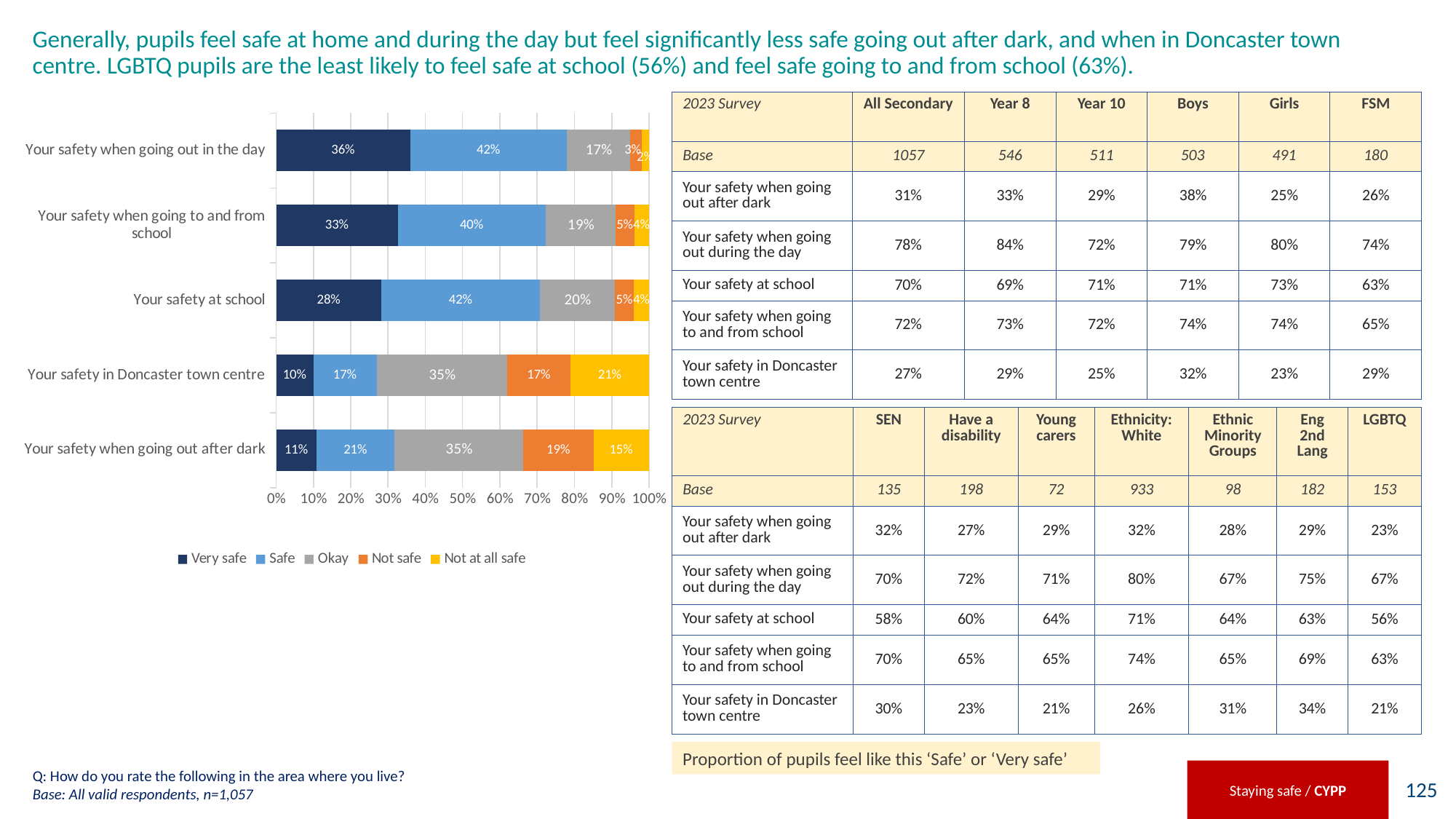
What is the combined 'Very safe' and 'Safe' total for 'Your safety when going to and from school'? 73% Which is larger: the 'Not safe' value for 'Your safety when going out after dark' or for 'Your safety in Doncaster town centre'? Your safety when going out after dark Which category has the highest 'Very safe' value? Your safety when going out in the day How many categories are plotted in the chart? 5 What is the 'Not at all safe' value for 'Your safety in Doncaster town centre'? 21% What is the 'Okay' value for 'Your safety when going out after dark'? 35% What is the 'Very safe' value for 'Your safety when going out in the day'? 36% Which category has the lowest 'Very safe' value? Your safety in Doncaster town centre What kind of chart is shown on the slide? Stacked bar chart How many series does the chart legend list? 5 Which colour represents the 'Not at all safe' series in the chart? Yellow What is the difference between the 'Safe' values for 'Your safety at school' and 'Your safety when going out after dark'? 21%